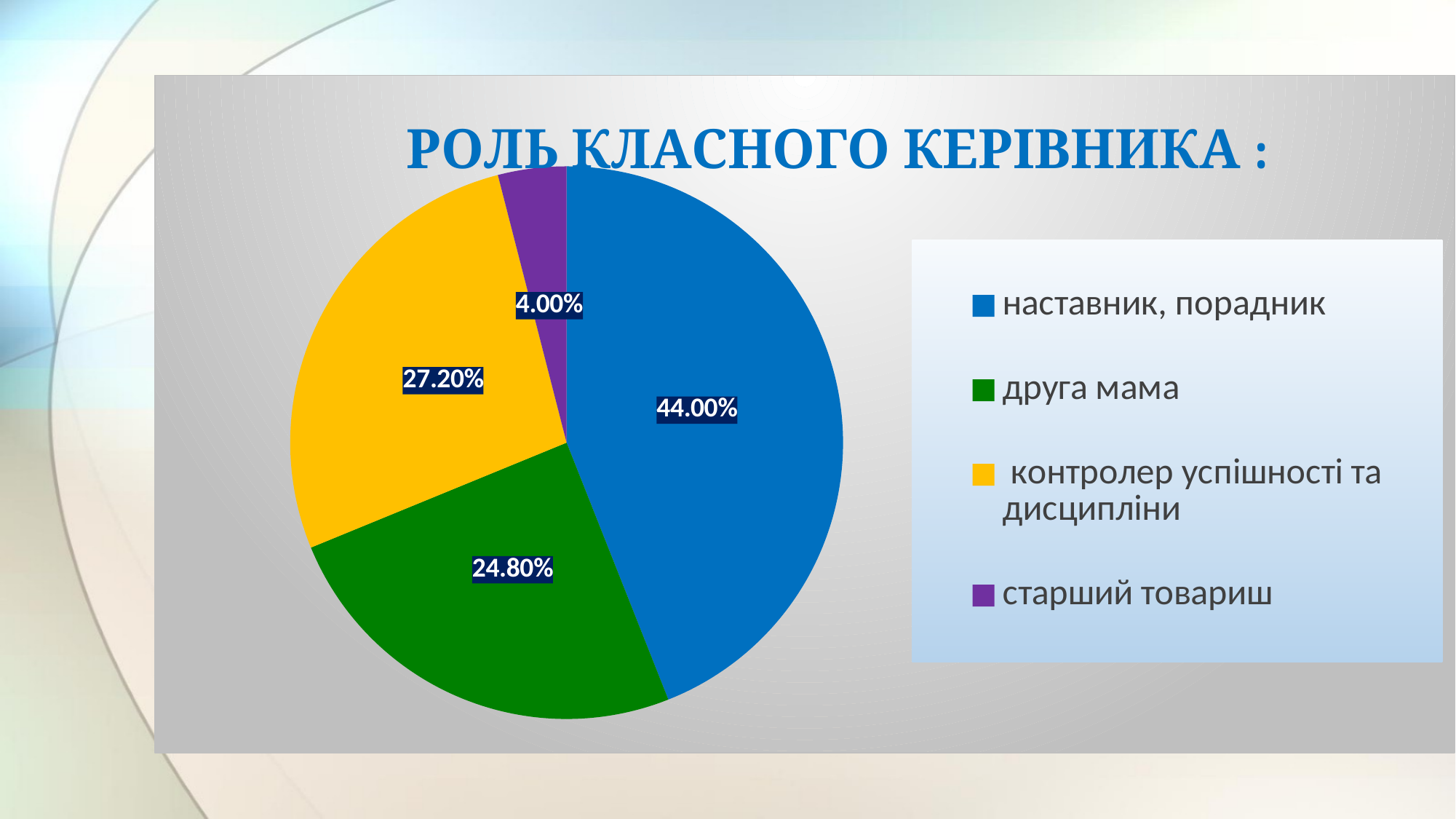
How many slices does the pie chart have? 4 What kind of chart is shown on the slide? Pie chart What is the value for "старший товариш"? 4.00% What is the title of the chart? РОЛЬ КЛАСНОГО КЕРІВНИКА : What is the difference between the values for "наставник, порадник" and "друга мама"? 19.20% What is the value for "контролер успішності та дисципліни"? 27.20% What is the value for "друга мама"? 24.80% What is the value for "наставник, порадник"? 44.00% Which is larger: the value for "контролер успішності та дисципліни" or the value for "друга мама"? контролер успішності та дисципліни Which category has the smallest share of the pie? старший товариш Which colour represents "старший товариш" in the legend? Purple Which category has the largest share of the pie? наставник, порадник